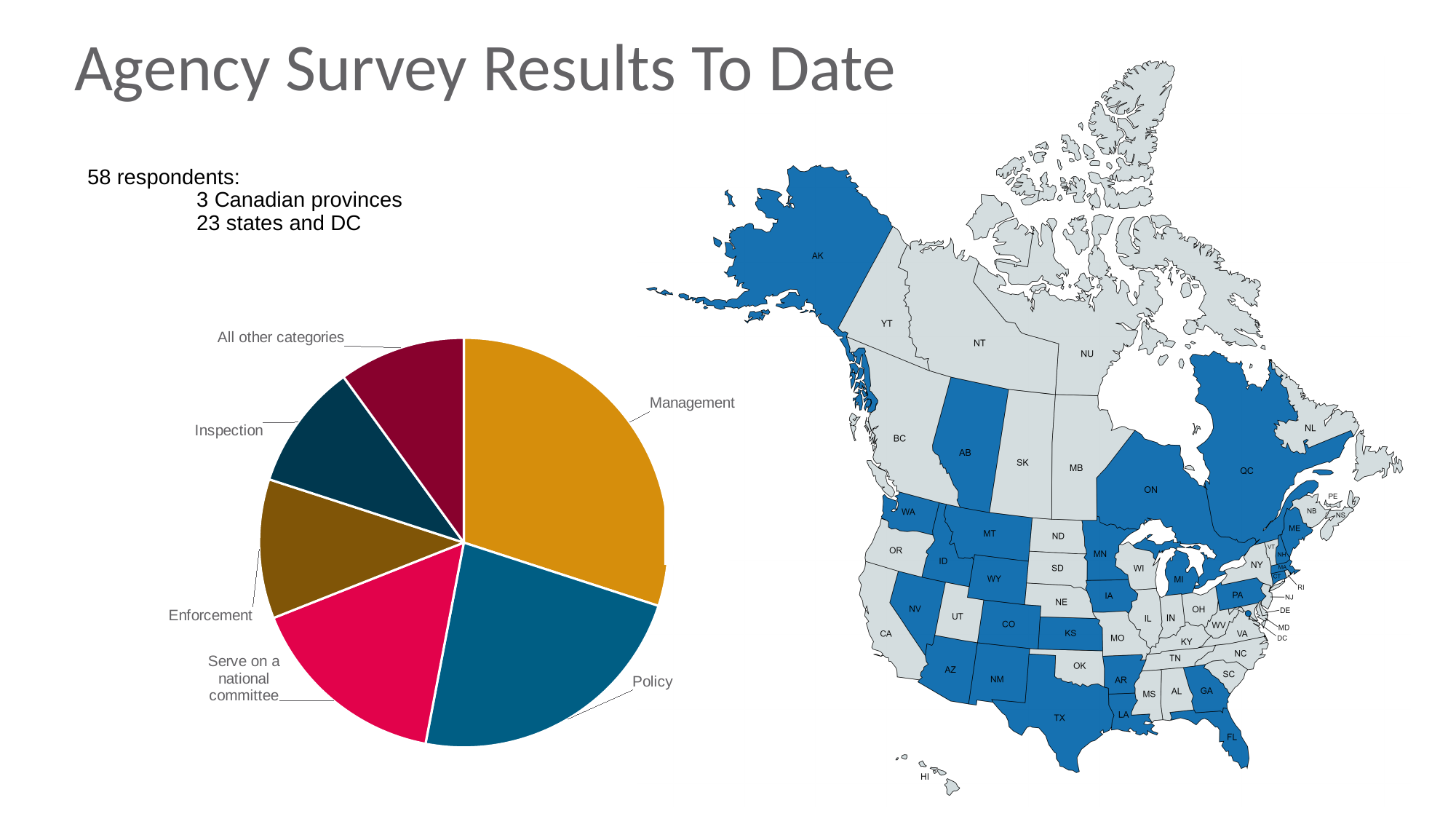
Which slice is larger in the pie chart, Policy or Inspection? Policy What is the title of the slide containing the pie chart? Agency Survey Results To Date How many categories (slices) does the pie chart have? 6 What kind of chart is shown on the left of the slide? pie chart Which slice is larger in the pie chart, Serve on a national committee or All other categories? Serve on a national committee Which slice is larger in the pie chart, Management or Policy? Management Which category has the largest slice in the pie chart? Management Which category in the pie chart is shown in orange? Management